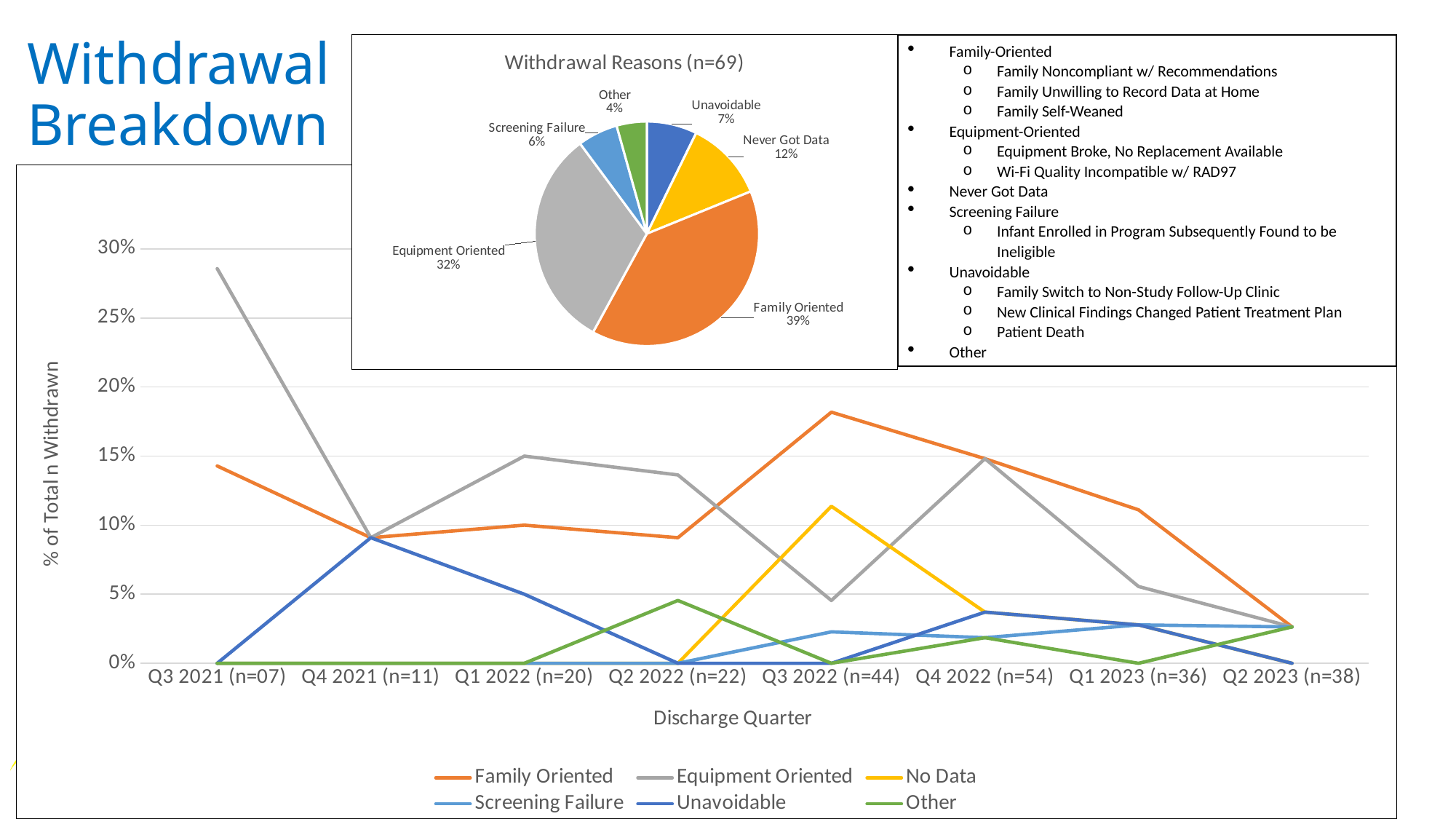
In the pie chart titled 'Withdrawal Reasons (n=69)', what percentage is Equipment Oriented? 32% In the pie chart titled 'Withdrawal Reasons (n=69)', what percentage is Never Got Data? 12% How many series does the legend of the line chart with 'Discharge Quarter' on the x axis list? 6 What kind of chart is the large chart at the bottom of the slide with 'Discharge Quarter' on the x axis? Line chart In the pie chart titled 'Withdrawal Reasons (n=69)', which reason has the largest share? Family Oriented In the pie chart titled 'Withdrawal Reasons (n=69)', what is the difference in percentage points between Family Oriented and Equipment Oriented? 7 In the pie chart titled 'Withdrawal Reasons (n=69)', which is larger, Unavoidable or Screening Failure? Unavoidable How many slices does the pie chart titled 'Withdrawal Reasons (n=69)' have? 6 In the line chart with 'Discharge Quarter' on the x axis, how many discharge quarters are shown? 8 In the line chart with 'Discharge Quarter' on the x axis, is the Equipment Oriented value for Q3 2021 (n=07) greater or less than 25%? greater In the pie chart titled 'Withdrawal Reasons (n=69)', what percentage is Family Oriented? 39% In the pie chart titled 'Withdrawal Reasons (n=69)', which reason has the smallest share? Other